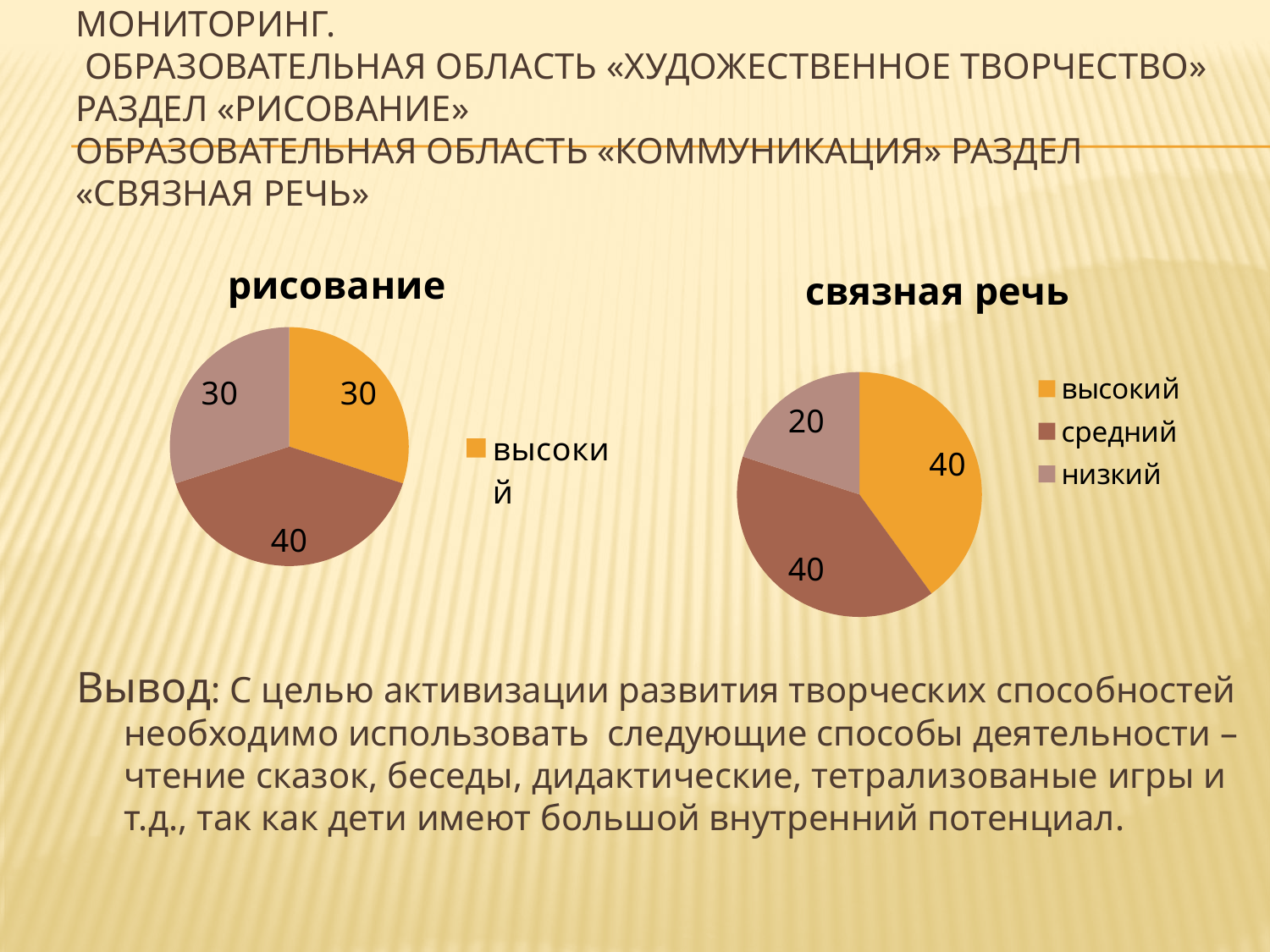
How many slices does the "рисование" pie chart have? 3 In the "связная речь" chart, which category has the lowest value? низкий In the "связная речь" chart, what is the value for средний? 40 In the "связная речь" chart, what is the difference between the values for высокий and низкий? 20 How many entries does the legend of the "связная речь" chart list? 3 In the "рисование" chart, what is the value for высокий? 30 In the "связная речь" chart, what is the value for низкий? 20 In the "связная речь" chart, which is larger, the value for высокий or the value for низкий? высокий In the "рисование" chart, what share of the total does the largest slice (40) represent? 40% In the "связная речь" chart, what share of the total does the низкий slice represent? 20% What kind of chart is the "связная речь" chart? pie chart What is the title of the pie chart on the left of the slide? рисование